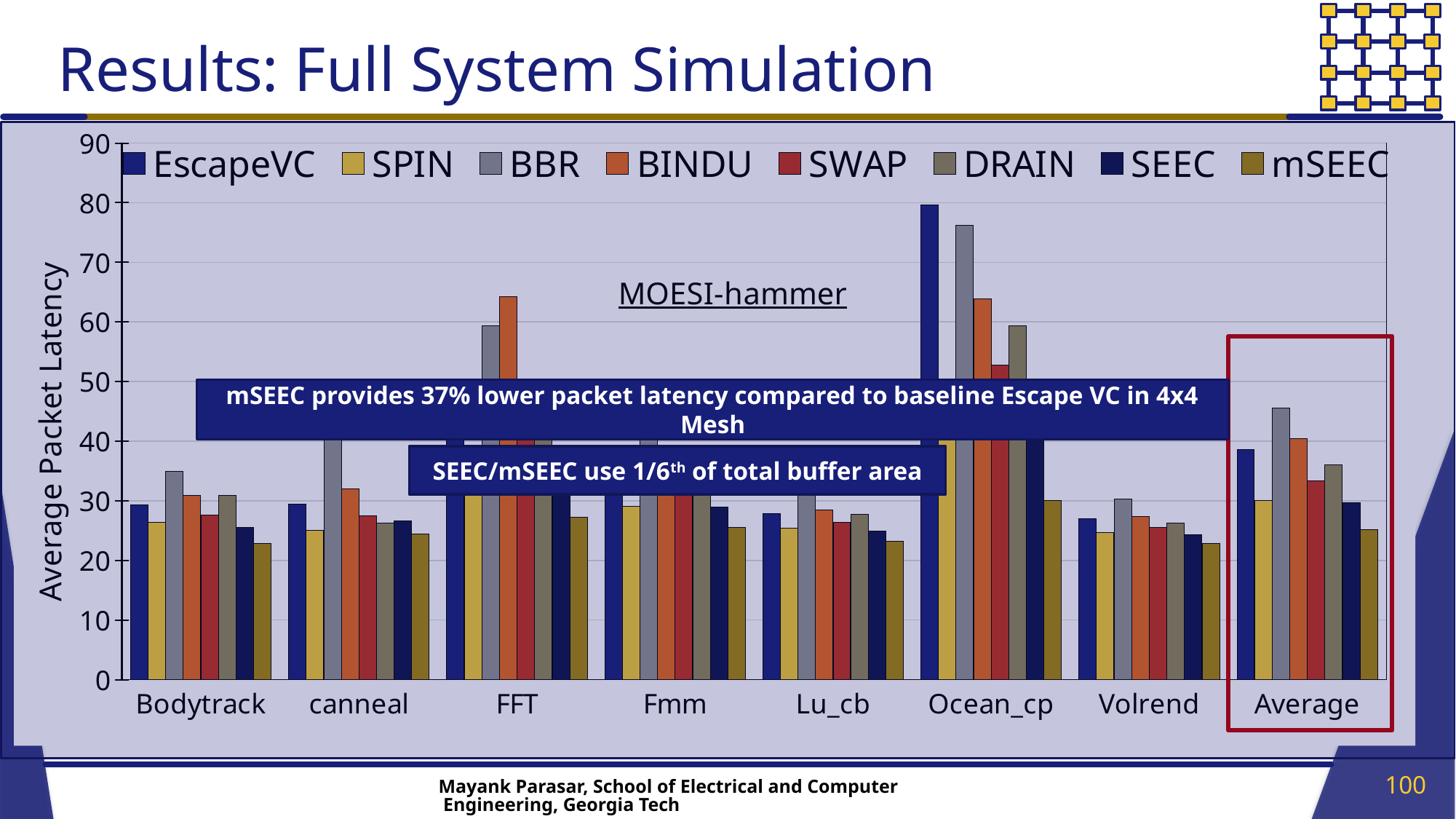
Which series has the lowest bar in the Average category? mSEEC What is the label on the vertical axis of the chart? Average Packet Latency For Bodytrack, which is larger: the BBR value or the EscapeVC value? BBR Is the BBR value for Average greater or less than 40? greater How many categories are shown along the x axis of the chart? 8 Is the mSEEC value for Average greater or less than 30? less Is the BINDU value for FFT greater or less than 60? greater What kind of chart is shown on the slide? bar chart What protocol name is written inside the chart area? MOESI-hammer How many series does the chart legend list? 8 For which category is the EscapeVC bar the highest? Ocean_cp